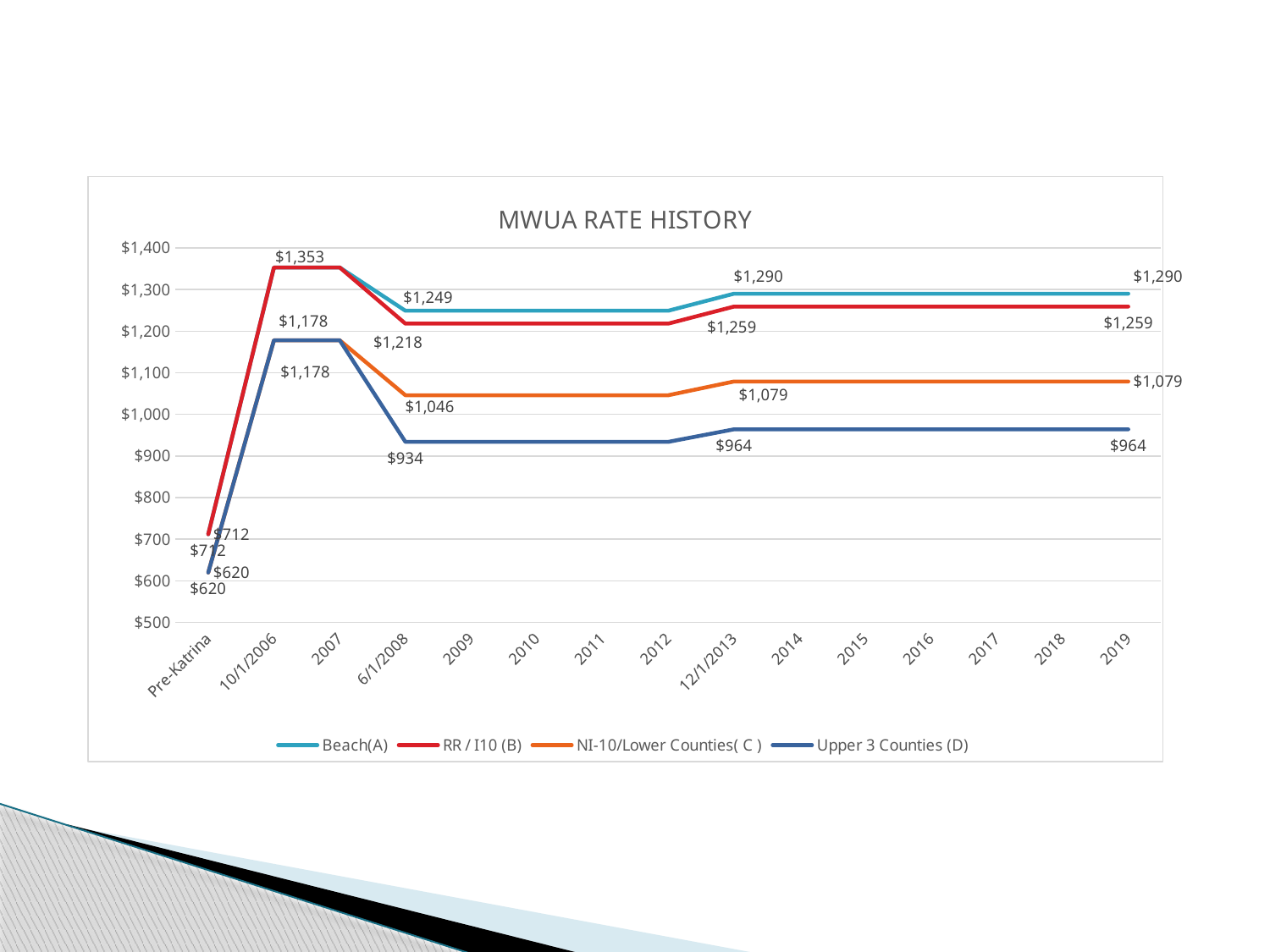
How many series does the legend of the MWUA RATE HISTORY chart list? 4 What is the value for Upper 3 Counties (D) at 6/1/2008? $934 Which is larger at 6/1/2008: RR / I10 (B) or NI-10/Lower Counties( C )? RR / I10 (B) Is the value for Beach(A) in 2010 greater or less than $1,200? greater What is the value for RR / I10 (B) at 10/1/2006? $1,353 What kind of chart is shown on the slide? line chart What is the difference between the Beach(A) and RR / I10 (B) values in 2019? $31 Which series has the highest value in 2019? Beach(A) How many categories are shown along the x axis of the chart? 15 What is the value for NI-10/Lower Counties( C ) at 12/1/2013? $1,079 Which series has the lowest value in 2019? Upper 3 Counties (D) What is the value for Beach(A) in 2019? $1,290